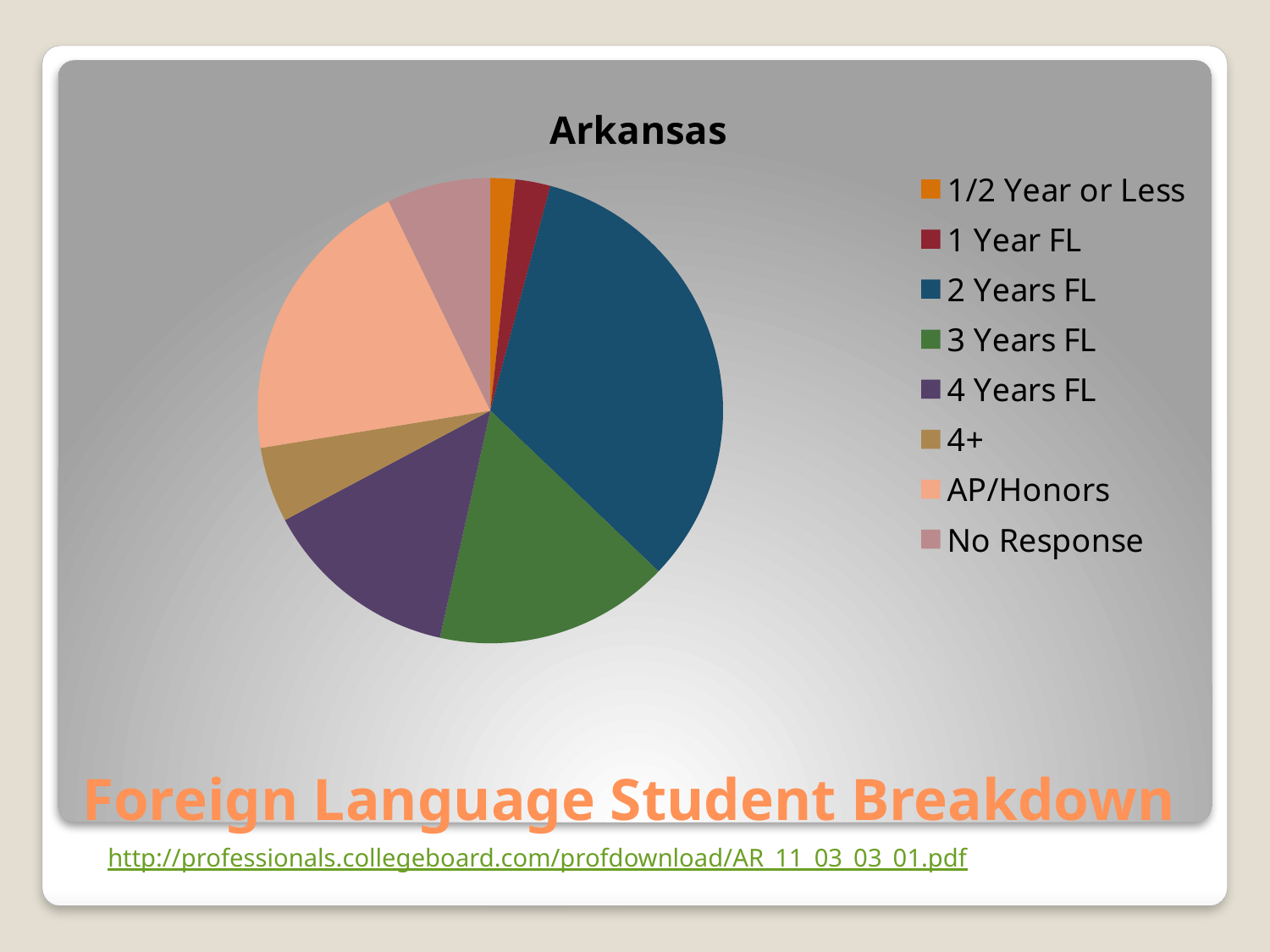
How many categories does the legend of the Arkansas pie chart list? 8 What kind of chart is shown on the slide? pie chart Which slice is larger in the Arkansas pie chart, AP/Honors or No Response? AP/Honors What is the title of the chart? Arkansas Which legend entry is listed first in the Arkansas pie chart? 1/2 Year or Less Which slice is larger in the Arkansas pie chart, 2 Years FL or 3 Years FL? 2 Years FL Which category has the largest slice in the Arkansas pie chart? 2 Years FL What colour is the 2 Years FL slice in the Arkansas pie chart? blue Which slice is larger in the Arkansas pie chart, AP/Honors or 1 Year FL? AP/Honors